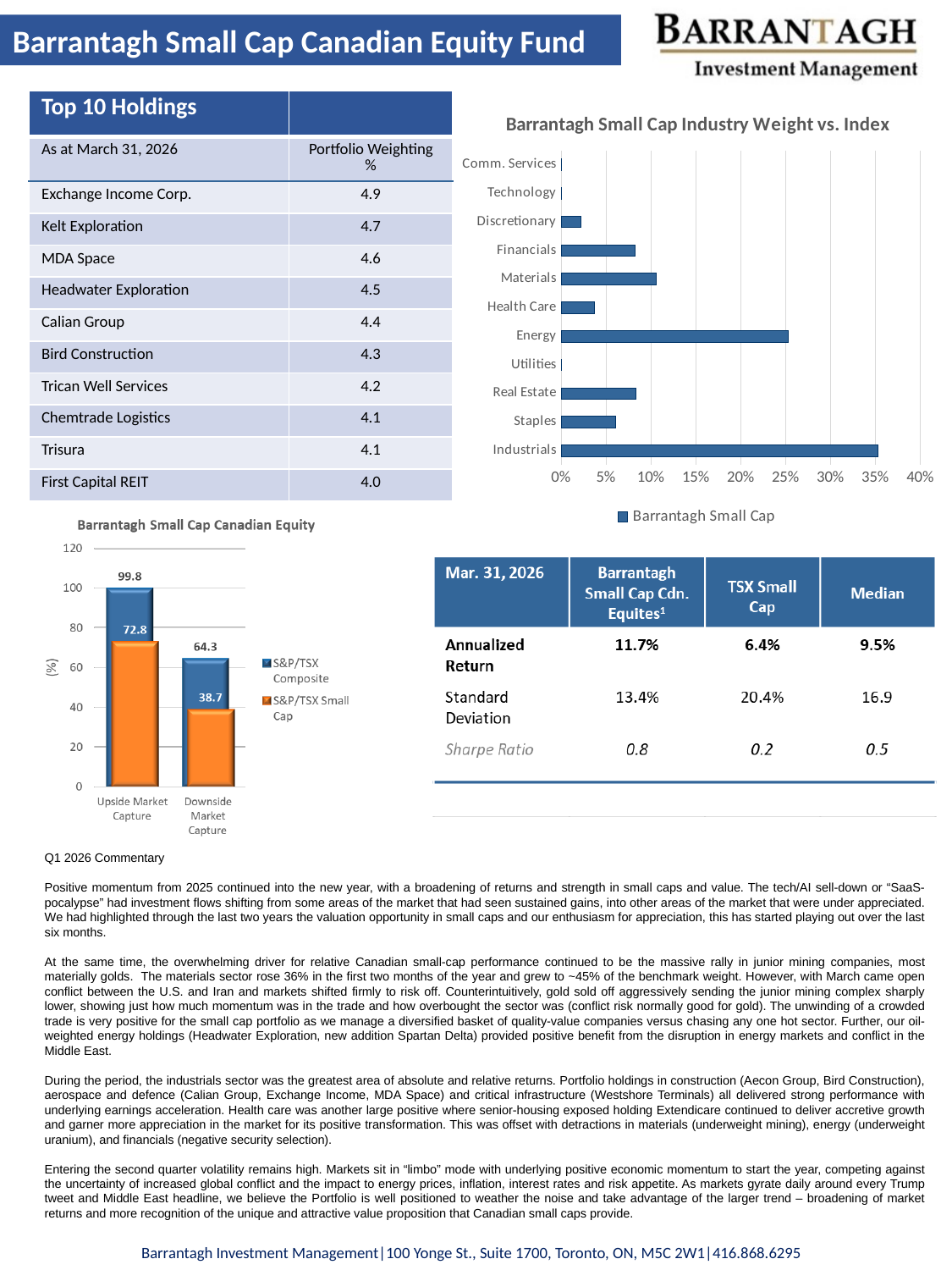
In the 'Barrantagh Small Cap Industry Weight vs. Index' chart, is the value for Industrials greater or less than 30%? greater In the 'Barrantagh Small Cap Industry Weight vs. Index' chart, is the value for Energy greater or less than 20%? greater What kind of chart is the 'Barrantagh Small Cap Industry Weight vs. Index' chart? bar chart In the 'Barrantagh Small Cap Industry Weight vs. Index' chart, is the value for Financials greater or less than 10%? less How many industry categories are listed on the y axis of the 'Barrantagh Small Cap Industry Weight vs. Index' chart? 11 How many series does the legend of the 'Barrantagh Small Cap Canadian Equity' chart list? 2 In the 'Barrantagh Small Cap Industry Weight vs. Index' chart, which industry has the highest weight? Industrials In the 'Barrantagh Small Cap Industry Weight vs. Index' chart, which has the larger weight, Energy or Materials? Energy In the 'Barrantagh Small Cap Canadian Equity' chart, what is the Downside Market Capture value for S&P/TSX Small Cap? 38.7 In the 'Barrantagh Small Cap Canadian Equity' chart, what is the difference between the Upside Market Capture values for S&P/TSX Composite and S&P/TSX Small Cap? 27.0 How many series does the legend of the 'Barrantagh Small Cap Industry Weight vs. Index' chart list? 1 In the 'Barrantagh Small Cap Canadian Equity' chart, what is the Upside Market Capture value for S&P/TSX Composite? 99.8